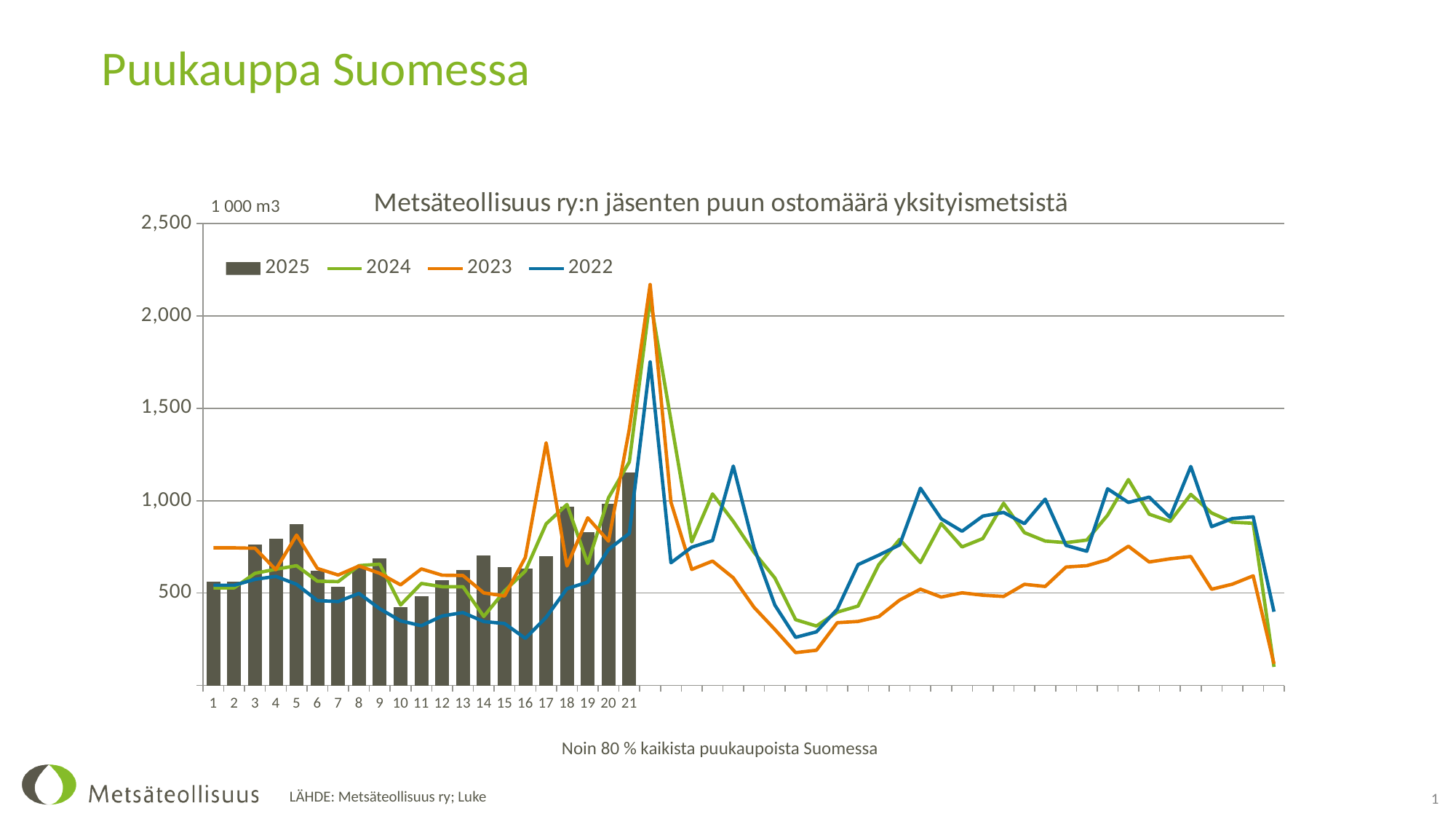
Is the 2025 value for week 21 greater or less than 1,000? greater How many bars are plotted for the 2025 series? 21 Which is larger for 2025: the bar for week 1 or the bar for week 21? Week 21 Is the peak of the 2022 line greater or less than 2,000? less Which series is shown as bars rather than a line? 2025 Is the 2025 value for week 16 greater or less than 1,000? less How many series does the chart legend list? 4 What kind of chart is this? Combined bar and line chart Which week has the highest 2025 bar? 21 What is the title of the chart? Metsäteollisuus ry:n jäsenten puun ostomäärä yksityismetsistä